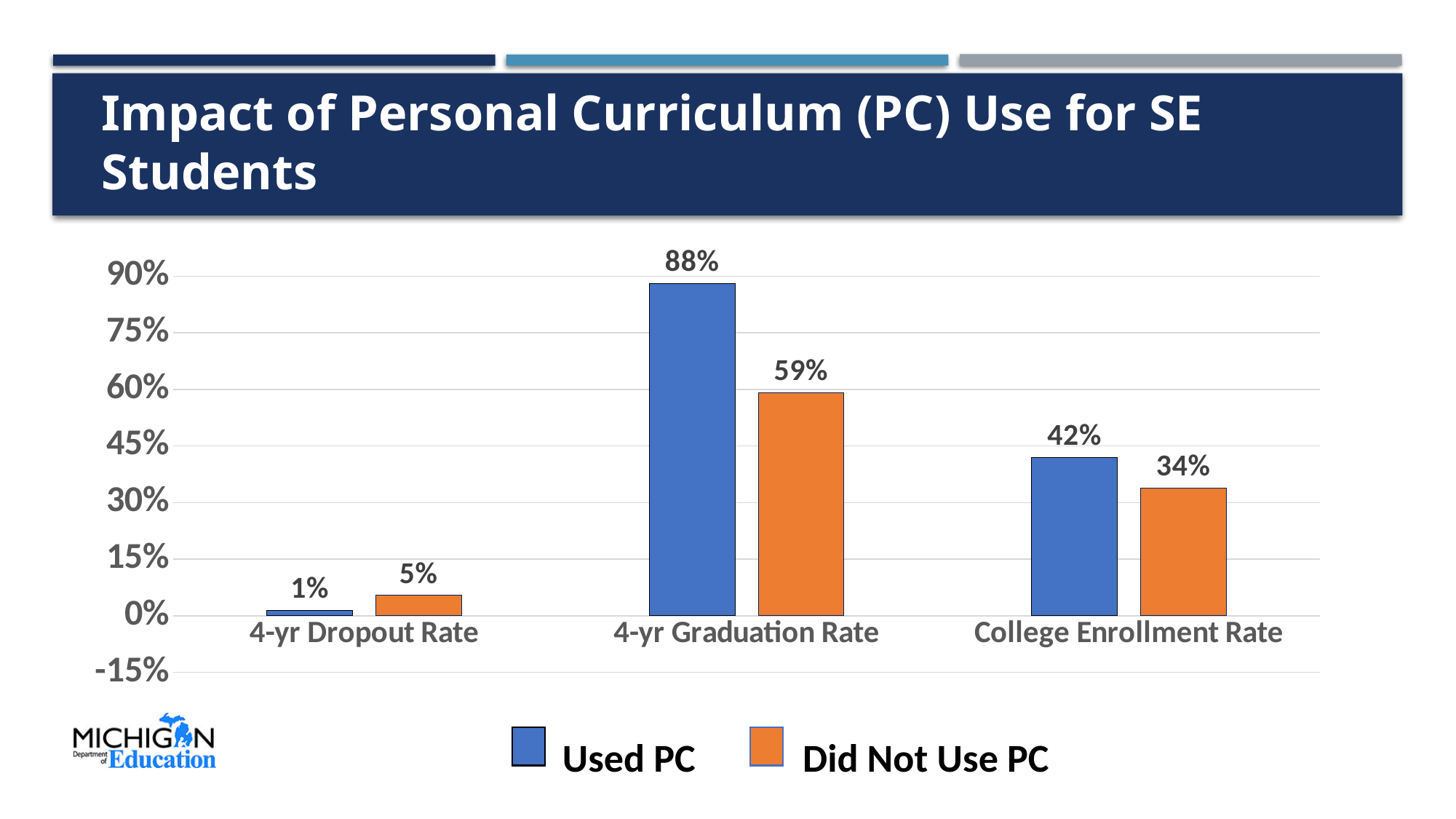
Which category has the lowest value for the Did Not Use PC series? 4-yr Dropout Rate What is the difference between the Used PC and Did Not Use PC values for College Enrollment Rate? 8% What is the College Enrollment Rate for students who Did Not Use PC? 34% Which category has the highest value for the Used PC series? 4-yr Graduation Rate Is the Did Not Use PC value for 4-yr Graduation Rate greater or less than 45%? greater What is the 4-yr Graduation Rate for students who Used PC? 88% What is the 4-yr Dropout Rate for students who Did Not Use PC? 5% How many categories are shown on the x axis? 3 What is the difference between the Used PC and Did Not Use PC values for 4-yr Graduation Rate? 29% What kind of chart is shown on the slide? bar chart How many series does the legend list? 2 For 4-yr Dropout Rate, which series has the larger value, Used PC or Did Not Use PC? Did Not Use PC